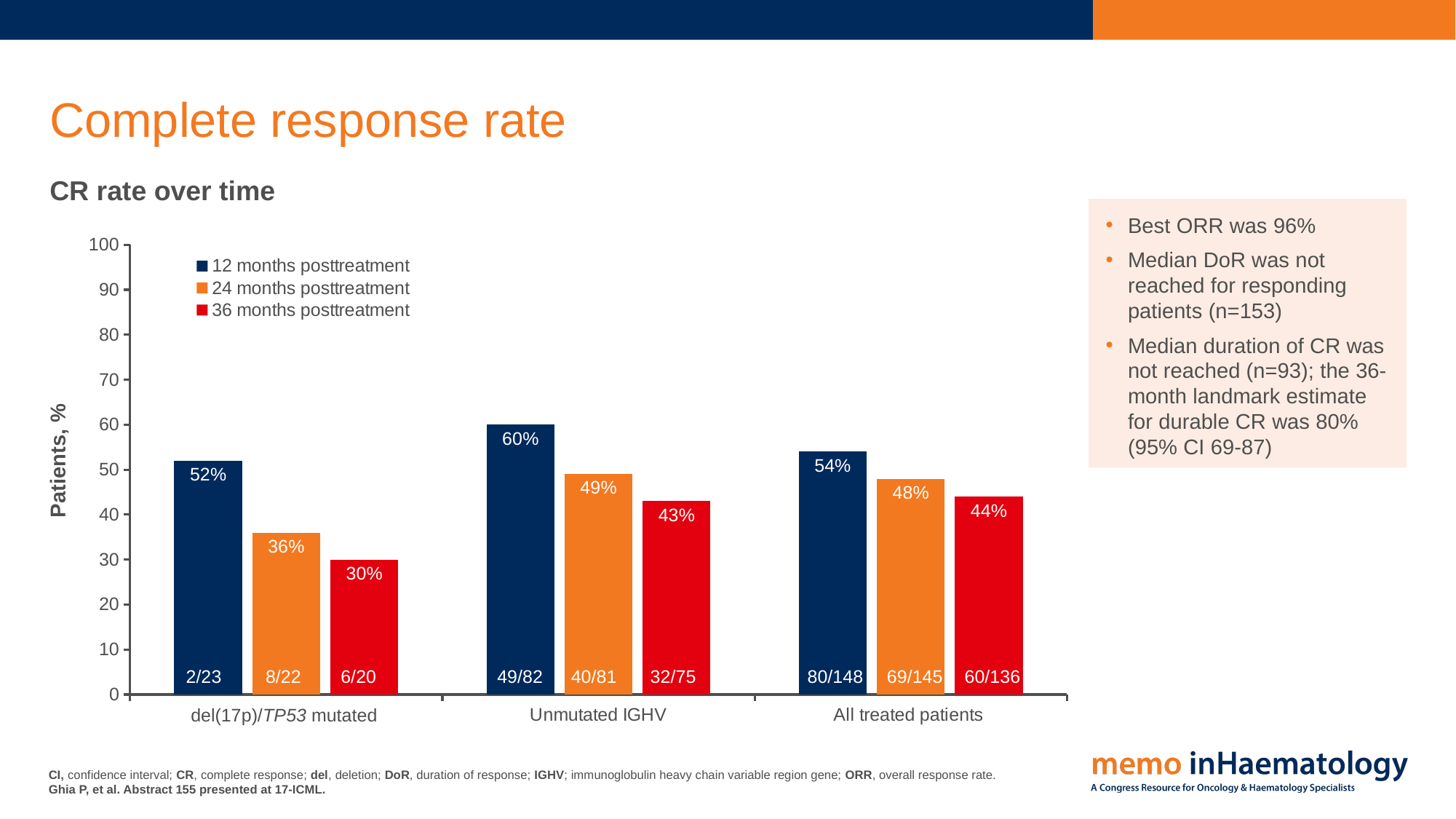
What kind of chart is shown on the slide? bar chart Is the 36-month CR rate for All treated patients greater or less than 50? less Is the 24-month CR rate higher for Unmutated IGHV or for All treated patients? Unmutated IGHV Which patient group has the lowest CR rate at 36 months posttreatment? del(17p)/TP53 mutated What is the CR rate at 36 months posttreatment for Unmutated IGHV patients? 43% What is the y-axis label of the chart? Patients, % What is the CR rate at 12 months posttreatment for the del(17p)/TP53 mutated group? 52% What is the CR rate at 24 months posttreatment for All treated patients? 48% How many series does the legend list? 3 How many patient groups are shown on the x axis? 3 What is the difference between the 12-month and 36-month CR rates for the del(17p)/TP53 mutated group? 22% Which patient group has the highest CR rate at 12 months posttreatment? Unmutated IGHV